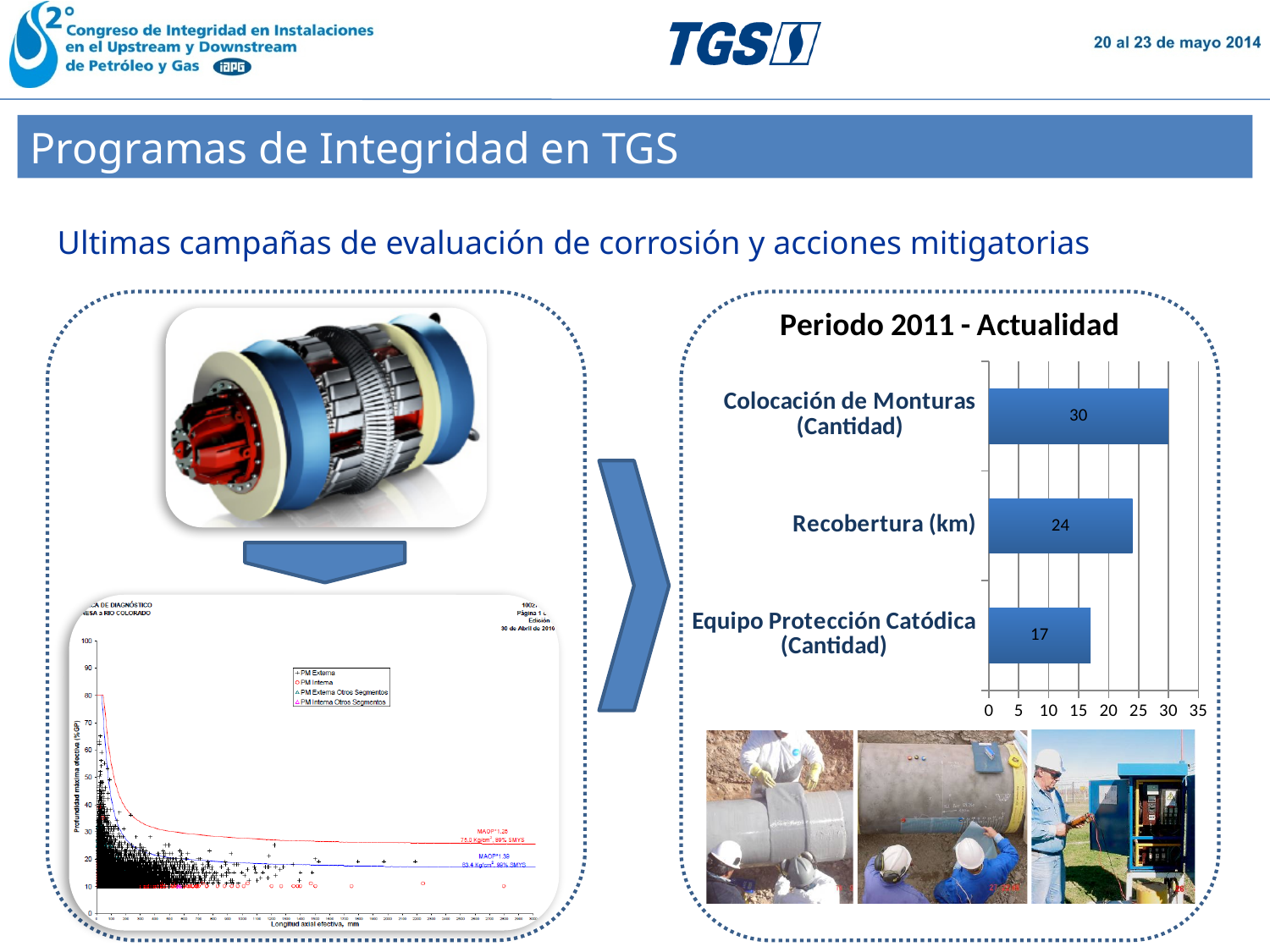
How many categories are shown in the 'Periodo 2011 - Actualidad' chart? 3 What is the maximum value shown on the horizontal axis of the 'Periodo 2011 - Actualidad' chart? 35 What kind of chart is the 'Periodo 2011 - Actualidad' chart? Bar chart In the 'Periodo 2011 - Actualidad' chart, what is the difference between the values for Colocación de Monturas and Recobertura? 6 In the 'Periodo 2011 - Actualidad' chart, what is the difference between the values for Colocación de Monturas and Equipo Protección Catódica? 13 In the 'Periodo 2011 - Actualidad' chart, is the value for Recobertura (km) greater or less than 20? greater In the 'Periodo 2011 - Actualidad' chart, which is larger: Recobertura (km) or Equipo Protección Catódica (Cantidad)? Recobertura (km) In the 'Periodo 2011 - Actualidad' chart, what is the value for Recobertura (km)? 24 In the 'Periodo 2011 - Actualidad' chart, which category has the highest value? Colocación de Monturas (Cantidad) In the 'Periodo 2011 - Actualidad' chart, what is the value for Equipo Protección Catódica (Cantidad)? 17 In the 'Periodo 2011 - Actualidad' chart, which category has the lowest value? Equipo Protección Catódica (Cantidad) In the 'Periodo 2011 - Actualidad' chart, what is the value for Colocación de Monturas (Cantidad)? 30